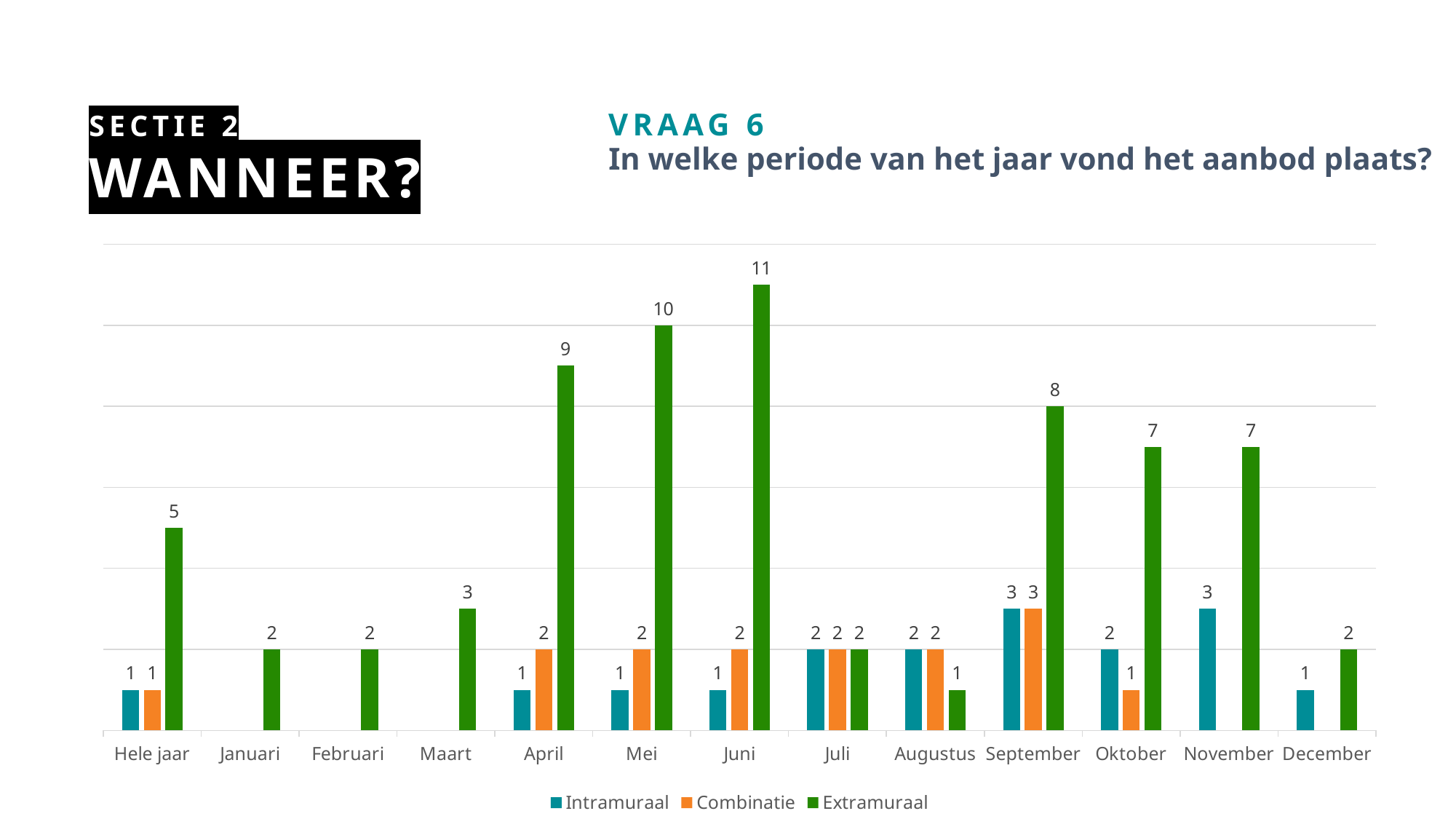
What kind of chart is shown on the slide? Bar chart Which series is shown in green in the legend? Extramuraal What is the difference between the Extramuraal values for Juni and Hele jaar? 6 Which category has the lowest Extramuraal value? Augustus What is the Combinatie value for Oktober? 1 How many series does the legend list? 3 What is the Extramuraal value for Juni? 11 Which is larger, the Extramuraal value for September or for Oktober? September What is the Intramuraal value for November? 3 What is the difference between the Extramuraal values for Mei and April? 1 How many categories are shown on the x axis? 13 Which category has the highest Extramuraal value? Juni